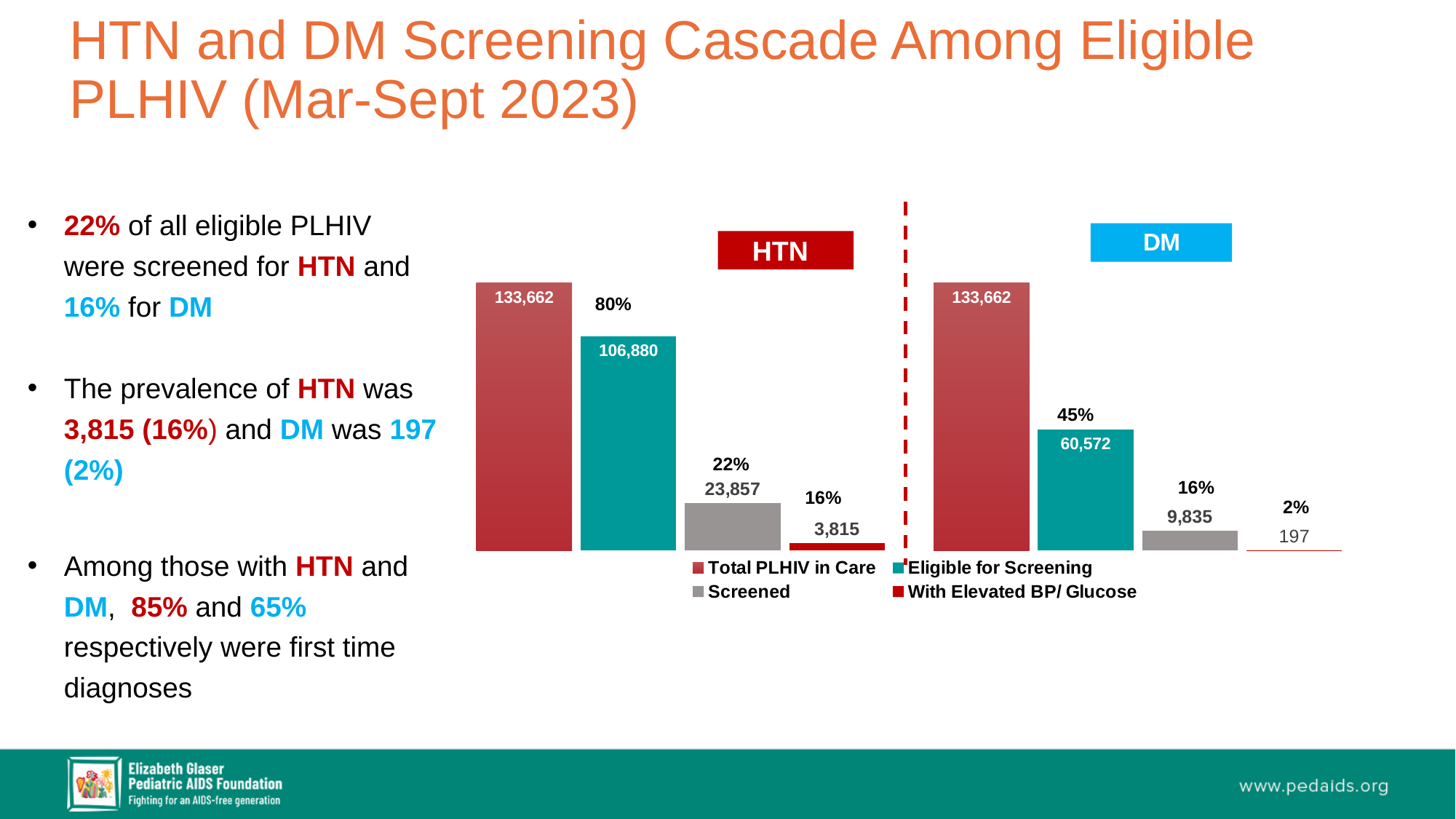
What kind of chart is shown on the slide? Bar chart What is the value of the Eligible for Screening bar in the HTN group? 106,880 Which series has the highest value in the DM group? Total PLHIV in Care What is the value of the With Elevated BP/ Glucose bar in the HTN group? 3,815 What is the value of the Total PLHIV in Care bar in the DM group? 133,662 What percentage is shown above the Eligible for Screening bar in the DM group? 45% How many series does the legend list? 4 What is the difference between the Screened value in the HTN group and the Screened value in the DM group? 14,022 Which series has the lowest value in the HTN group? With Elevated BP/ Glucose Which group has the larger Eligible for Screening value, HTN or DM? HTN What is the value of the Screened bar in the DM group? 9,835 How many groups of bars are shown in the chart? 2